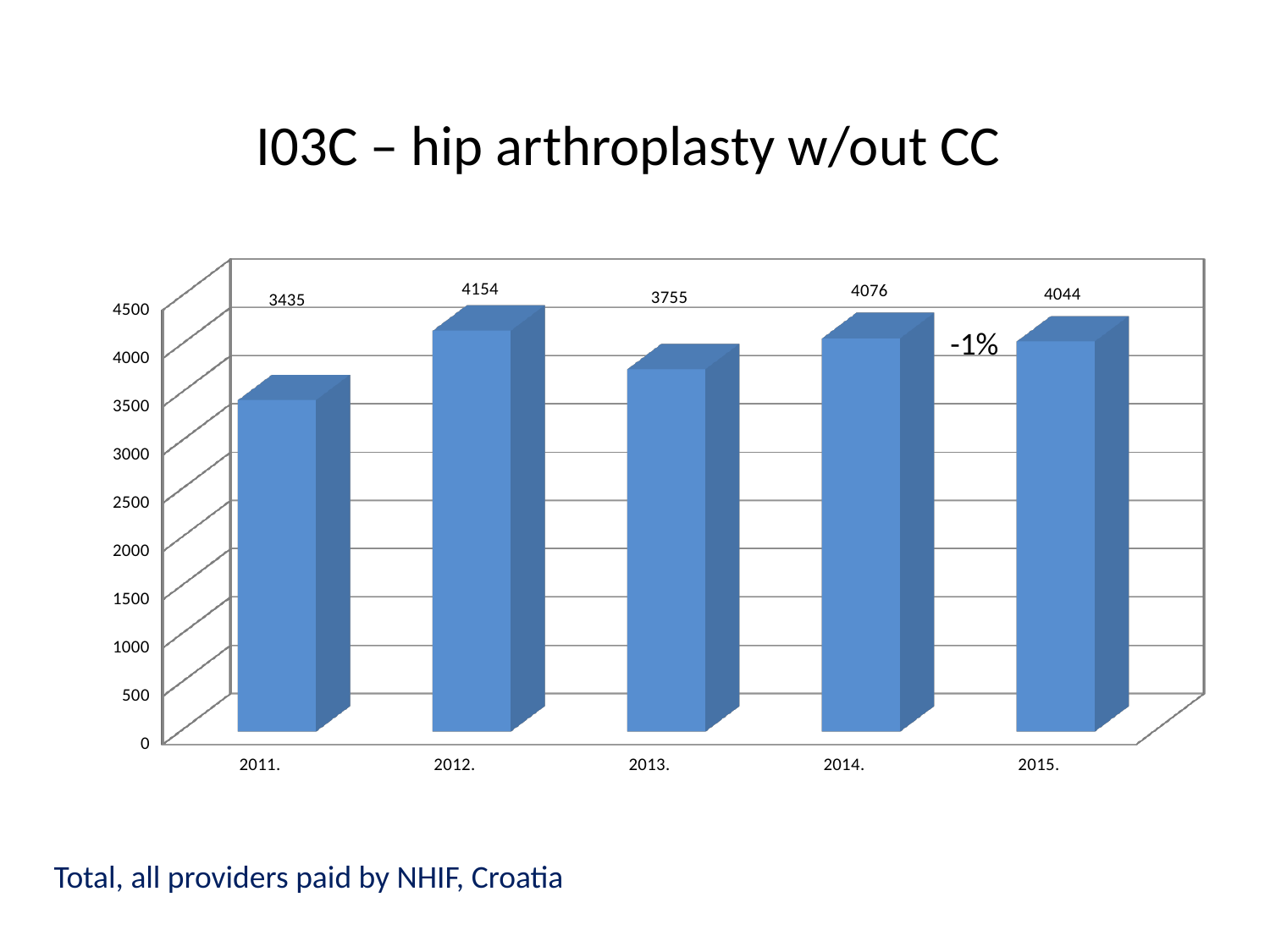
Which year has the highest value? 2012. What is the title of the chart? I03C – hip arthroplasty w/out CC What is the difference between the values for 2012. and 2011.? 719 What is the value for 2015.? 4044 How many years are shown on the x axis? 5 What is the difference between the values for 2014. and 2015.? 32 What is the value for 2011.? 3435 Is the value for 2011. greater or less than 4000? less What is the value for 2013.? 3755 Which year has the lowest value? 2011. What kind of chart is shown on the slide? bar chart Which is larger, the value for 2013. or the value for 2014.? 2014.